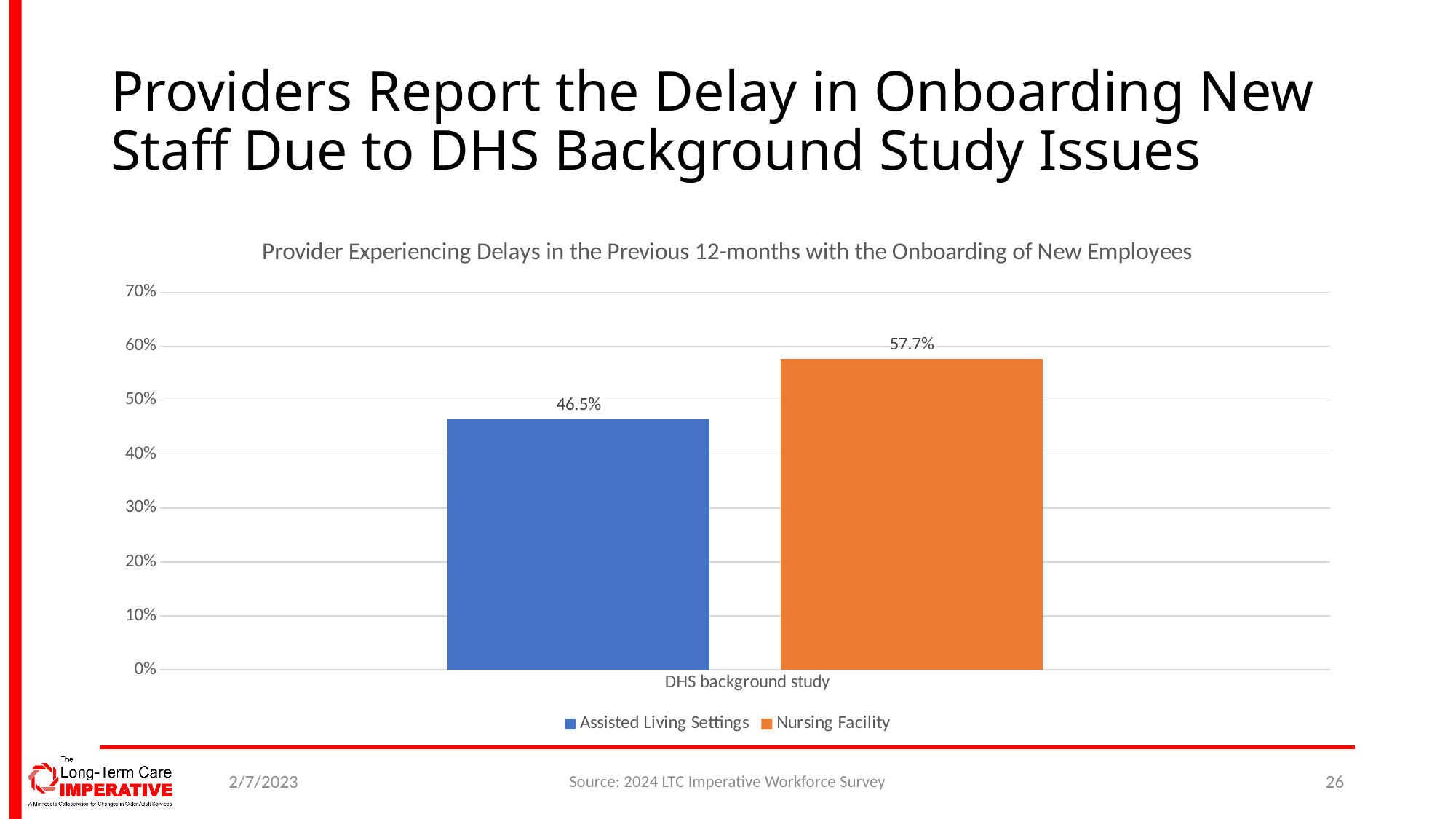
How many categories are shown on the x axis? 1 Is the value for Assisted Living Settings greater or less than 50%? less What is the value for Nursing Facility for DHS background study? 57.7% What kind of chart is shown on the slide? bar chart How many series does the legend list? 2 What is the value for Assisted Living Settings for DHS background study? 46.5% Is the value for Assisted Living Settings larger or smaller than the value for Nursing Facility? smaller What is the title of the chart? Provider Experiencing Delays in the Previous 12-months with the Onboarding of New Employees What is the difference between the Nursing Facility and Assisted Living Settings values? 11.2% Which series has the lower value for DHS background study? Assisted Living Settings Is the value for Nursing Facility greater or less than 50%? greater Which series has the higher value for DHS background study? Nursing Facility